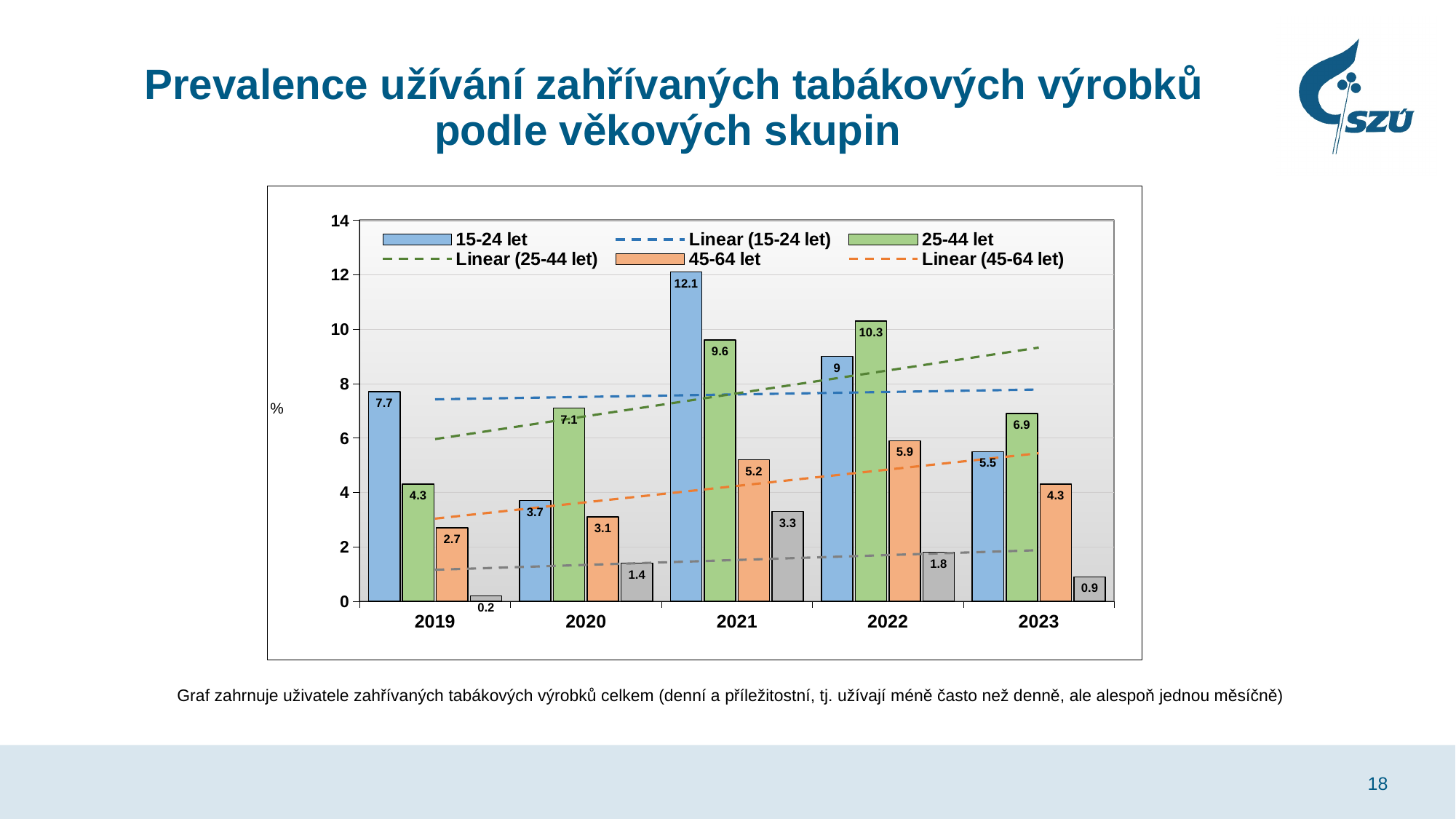
How many years are shown on the x axis? 5 What is the value for the 15-24 let group in 2021? 12.1 What is the value for the 15-24 let group in 2023? 5.5 How many entries does the legend list? 6 Is the value for the 25-44 let group in 2020 greater or less than 6? greater In which year is the value for the 45-64 let group lowest? 2019 What is the difference between the 15-24 let value in 2021 and the 15-24 let value in 2020? 8.4 What is the value for the 45-64 let group in 2019? 2.7 Which is larger in 2022: the value for 15-24 let or the value for 25-44 let? 25-44 let What is the value for the 25-44 let group in 2022? 10.3 In which year is the value for the 15-24 let group highest? 2021 What kind of chart is shown on the slide? Bar chart